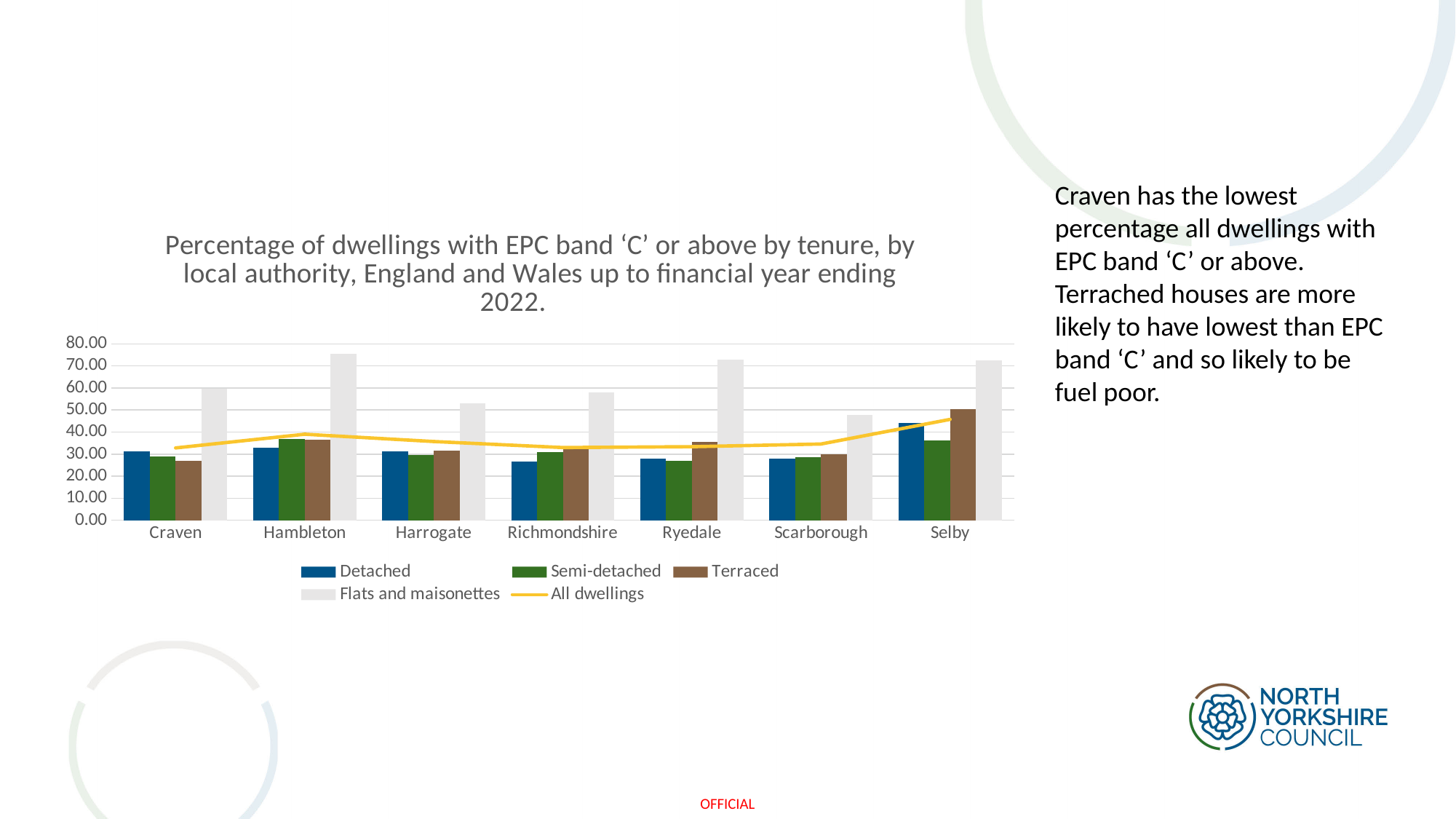
Is the Flats and maisonettes value for Craven greater or less than 50.00? greater Which local authority has the highest All dwellings value? Selby How many series does the chart legend list? 5 In Selby, which is larger: the Terraced value or the Detached value? Terraced Is the Terraced value for Selby greater or less than 40.00? greater What kind of chart is shown on the slide? bar chart with a line How many local authorities are shown on the x axis of the chart? 7 Which local authority has the lowest Flats and maisonettes value? Scarborough Which local authority has the highest Detached value? Selby Which is larger: the Flats and maisonettes value for Hambleton or for Harrogate? Hambleton What colour is the All dwellings line in the chart? yellow Is the Detached value for Richmondshire greater or less than 30.00? less